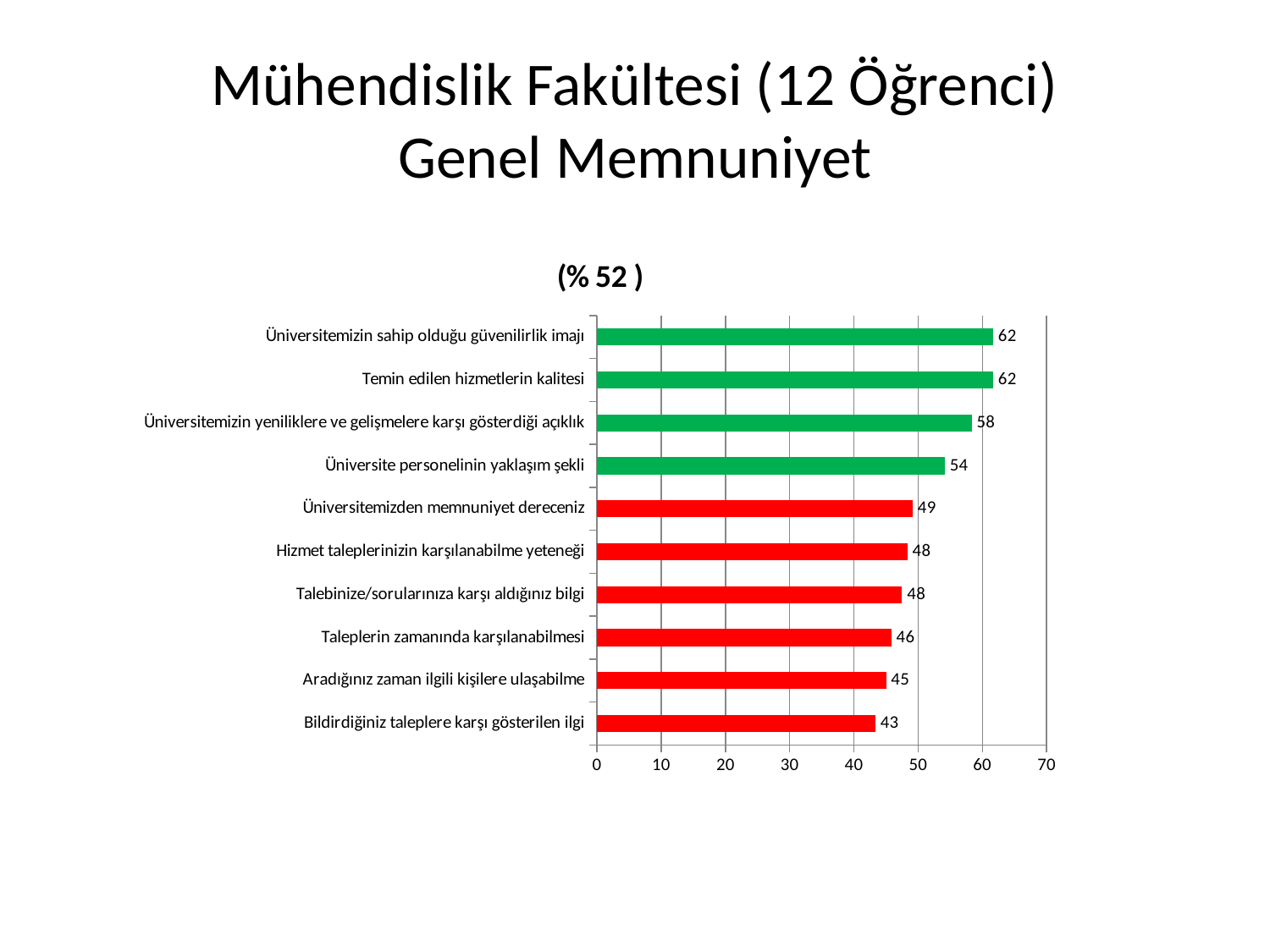
What is the value for "Üniversite personelinin yaklaşım şekli"? 54 How many categories are shown in the chart? 10 What is the difference between the values for "Üniversite personelinin yaklaşım şekli" and "Üniversitemizden memnuniyet dereceniz"? 5 What is the value for "Üniversitemizden memnuniyet dereceniz"? 49 What is the value for "Bildirdiğiniz taleplere karşı gösterilen ilgi"? 43 What is the value for "Üniversitemizin yeniliklere ve gelişmelere karşı gösterdiği açıklık"? 58 What is the title of the chart? (% 52 ) Is the value for "Aradığınız zaman ilgili kişilere ulaşabilme" greater or less than 50? less What kind of chart is shown on the slide? bar chart What is the difference between the values for "Üniversitemizin sahip olduğu güvenilirlik imajı" and "Bildirdiğiniz taleplere karşı gösterilen ilgi"? 19 Which category has the lowest value? Bildirdiğiniz taleplere karşı gösterilen ilgi Which is larger: the value for "Taleplerin zamanında karşılanabilmesi" or the value for "Üniversite personelinin yaklaşım şekli"? Üniversite personelinin yaklaşım şekli